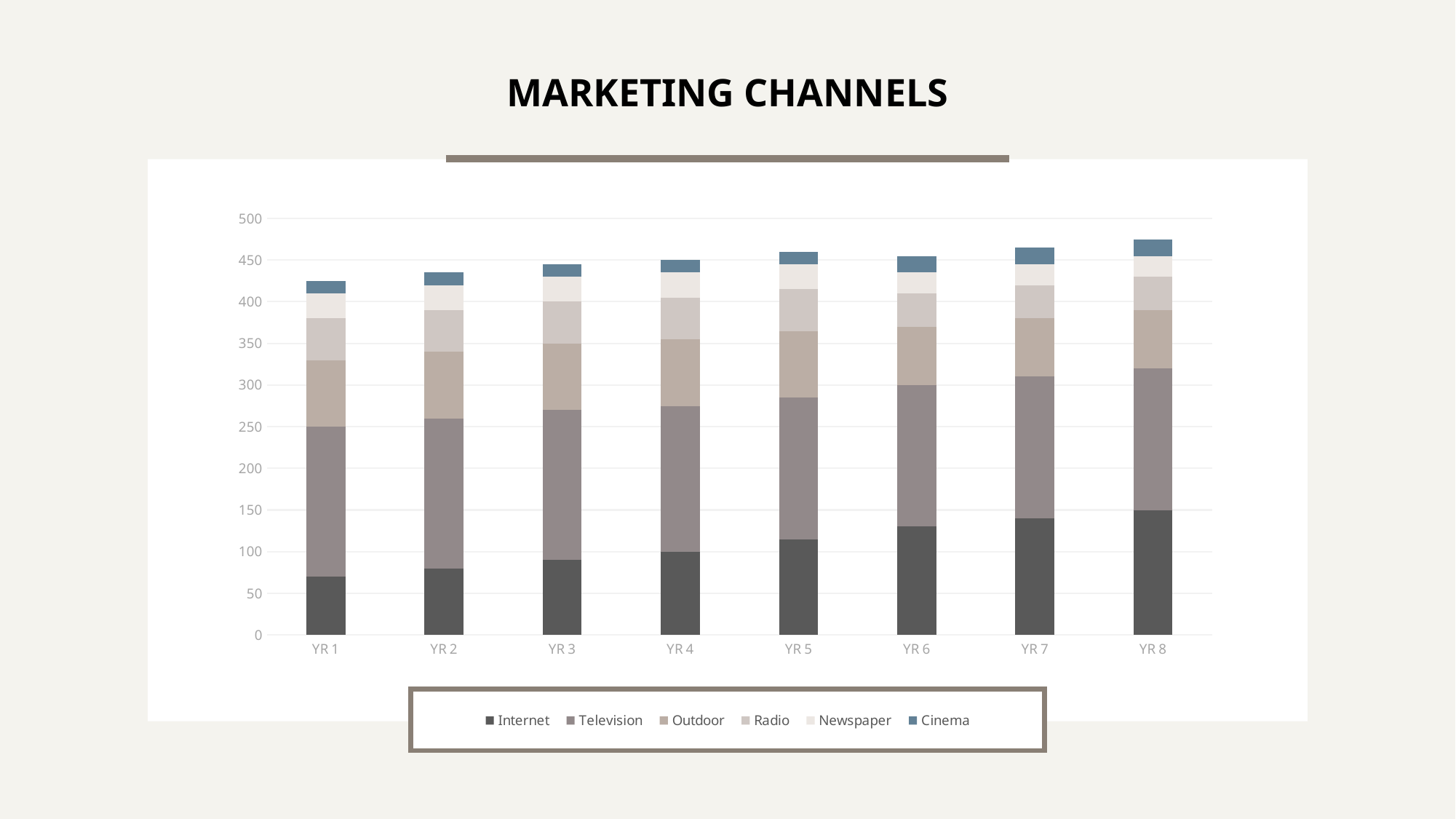
Is the total stacked value for YR 8 greater or less than 450? greater What kind of chart is shown on the slide? stacked bar chart How many year categories are shown on the x axis? 8 Which year has the tallest stacked bar overall? YR 8 Is the Internet value for YR 8 greater or less than 100? greater Is the total stacked value for YR 1 greater or less than 450? less Do the Internet values rise or fall from YR 1 to YR 8? rise How many series does the legend list? 6 Which year has the shortest stacked bar overall? YR 1 What is the title of the chart? MARKETING CHANNELS Which series is shown in blue at the top of each bar? Cinema